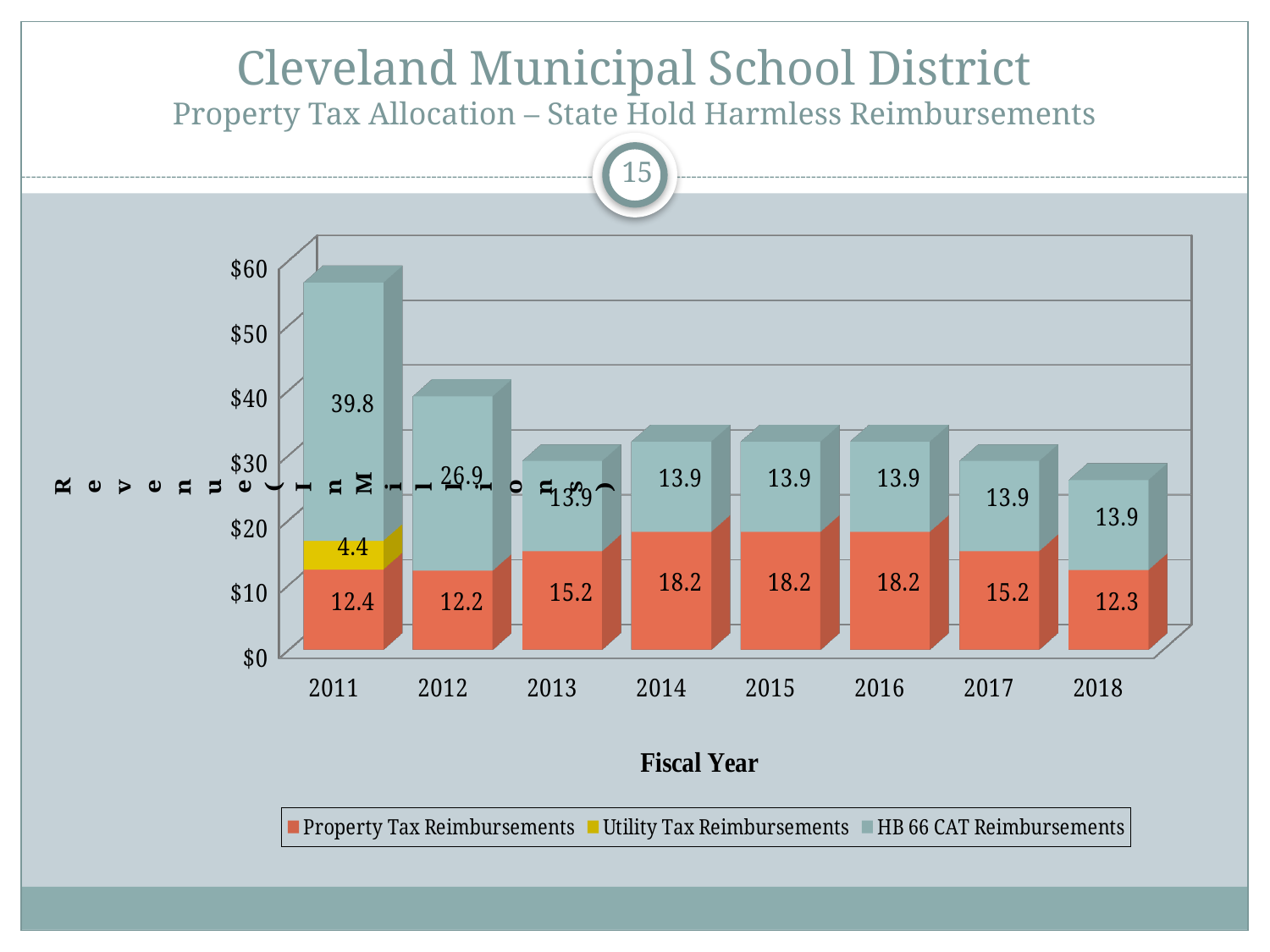
Which fiscal year has the highest HB 66 CAT Reimbursements? 2011 What is the value of Property Tax Reimbursements for fiscal year 2014? 18.2 What is the difference between HB 66 CAT Reimbursements in 2011 and 2012? 12.9 What is the total of the stacked bar for fiscal year 2011? 56.6 How many fiscal years are shown on the x axis? 8 What is the value of HB 66 CAT Reimbursements for fiscal year 2011? 39.8 Is the total stacked bar for 2011 greater or less than $50? greater What kind of chart is shown on the slide? Stacked bar chart Which fiscal year has the lowest Property Tax Reimbursements? 2012 How many series does the legend list? 3 What is the value of Utility Tax Reimbursements for fiscal year 2011? 4.4 Which is larger, Property Tax Reimbursements in 2013 or in 2018? 2013